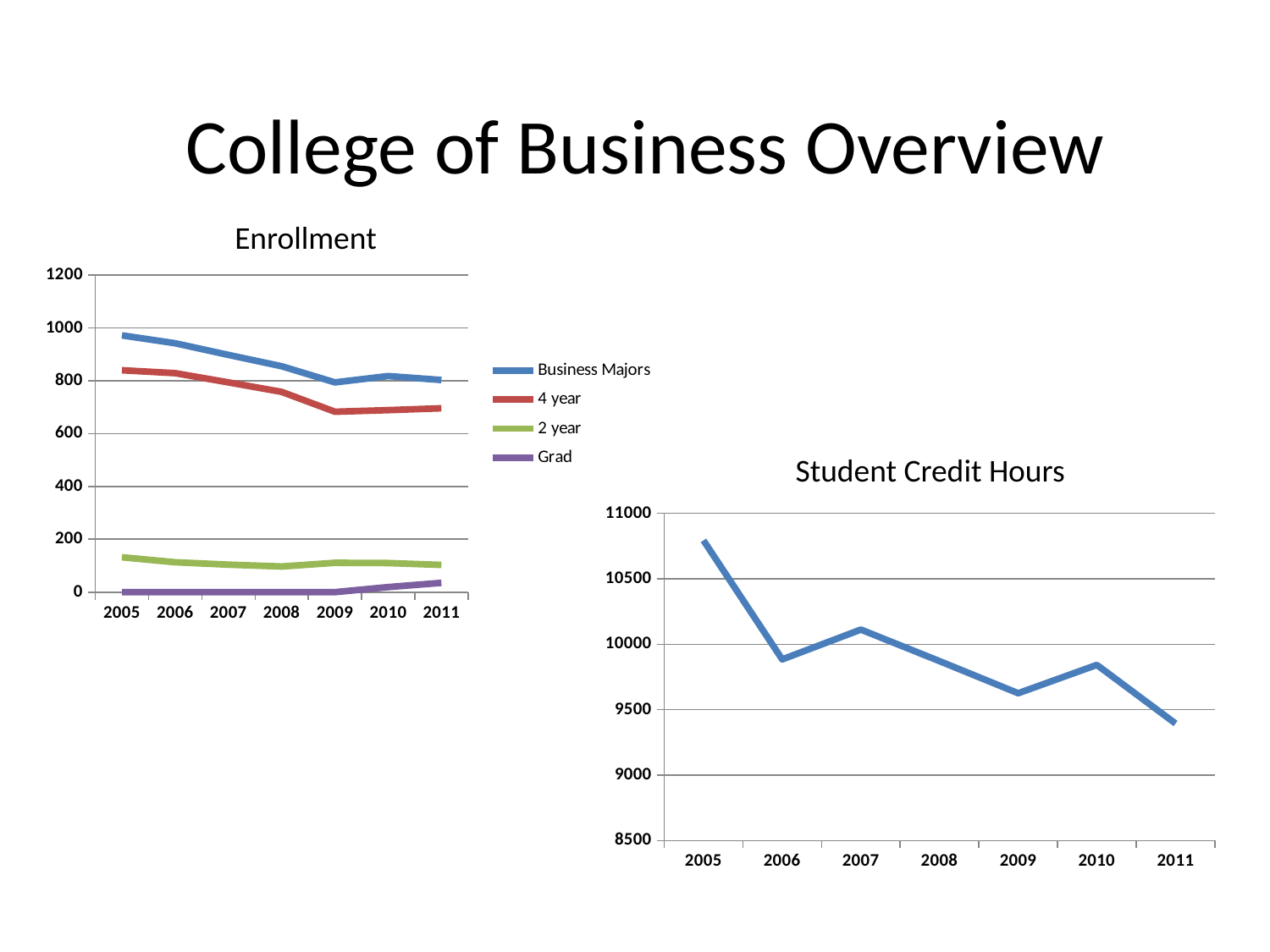
On the Student Credit Hours chart, is the value for 2005 greater or less than 10500? greater On the Student Credit Hours chart, is the value for 2011 greater or less than 9500? less On the Enrollment chart, which series has the lowest values across all years? Grad What kind of chart is the Student Credit Hours chart? line chart On the Enrollment chart, how many series does the legend list? 4 On the Enrollment chart, which series has the highest values across all years? Business Majors On the Student Credit Hours chart, do the values generally rise or fall from 2005 to 2011? fall On the Enrollment chart, is the value for 4 year in 2009 greater or less than 800? less On the Student Credit Hours chart, which year has the highest value? 2005 On the Student Credit Hours chart, how many years are plotted along the x axis? 7 On the Student Credit Hours chart, which year has the lowest value? 2011